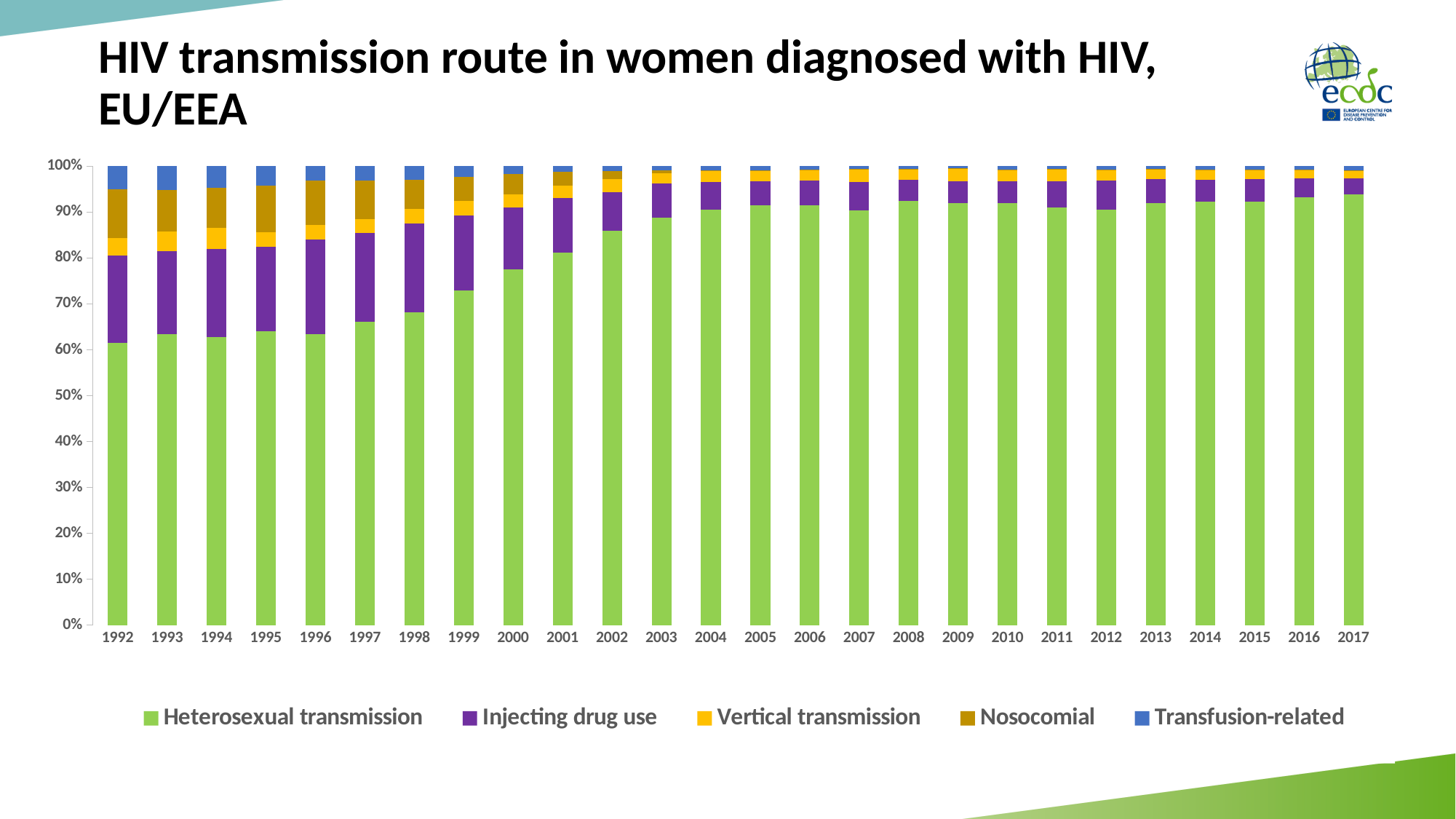
How many years are shown along the x axis? 26 What is the title of the chart? HIV transmission route in women diagnosed with HIV, EU/EEA Which year has the larger share of heterosexual transmission, 1992 or 2017? 2017 How many series does the legend list? 5 Does the share of injecting drug use rise or fall from 1992 to 2017? Fall Which transmission route is listed first in the legend? Heterosexual transmission Is the share of heterosexual transmission in 1992 greater or less than 70%? less Does the share of heterosexual transmission rise or fall from 1992 to 2017? Rise What is the total of the stacked bar for 2005? 100% Is the share of heterosexual transmission in 2017 greater or less than 90%? greater What kind of chart is shown on the slide? Stacked bar chart Is the share of heterosexual transmission in 2000 greater or less than 70%? greater